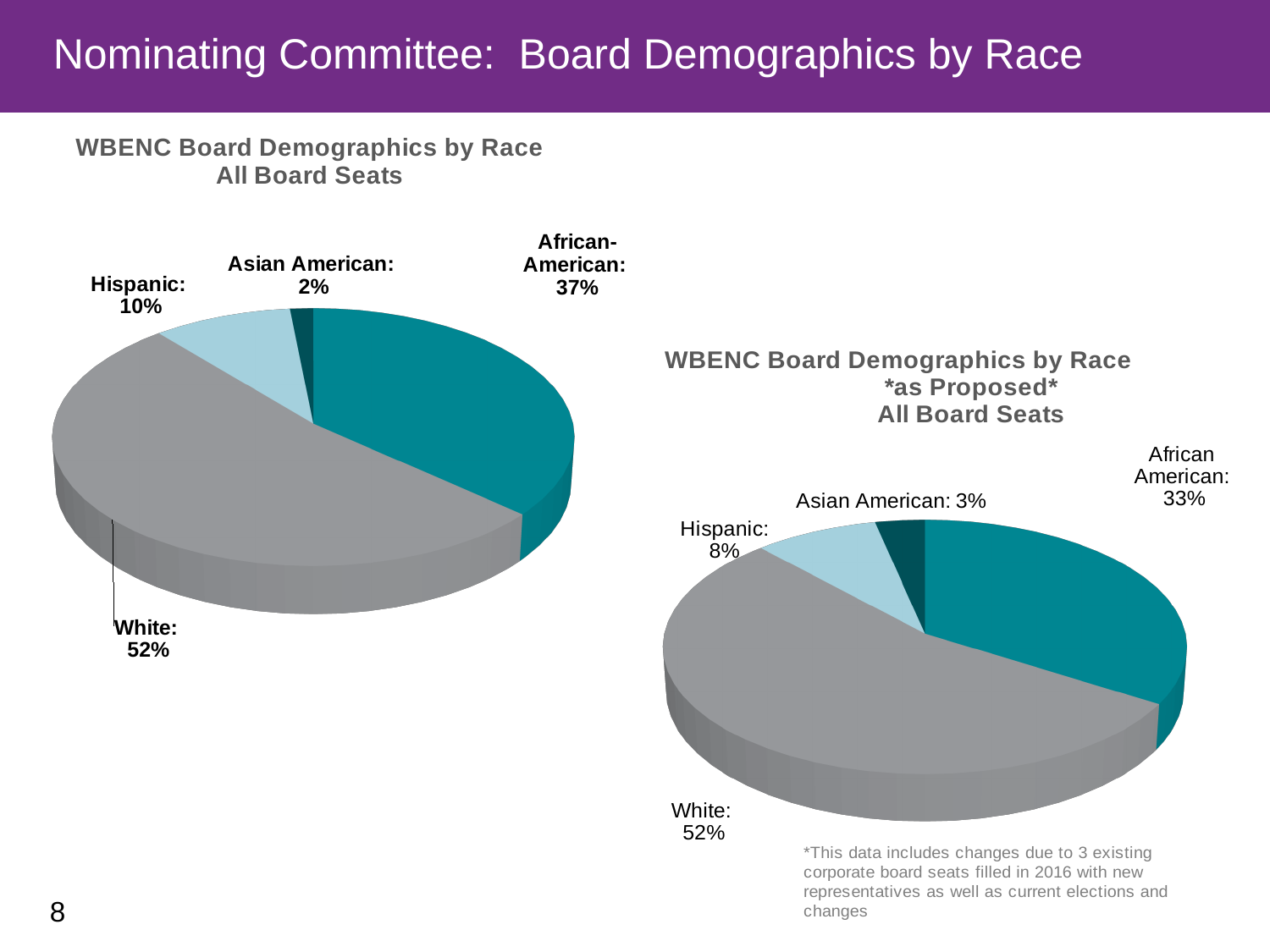
In the left pie chart (All Board Seats), what is the difference between the White share and the African-American share? 15% In the right pie chart (*as Proposed*), what is the difference between the Hispanic share and the Asian American share? 5% In the left pie chart (All Board Seats), which group holds the smallest share of board seats? Asian American In the right pie chart (*as Proposed*), what share of board seats is held by African American members? 33% How many categories are shown in the right pie chart (*as Proposed*)? 4 In the left pie chart (All Board Seats), what share of board seats is held by Hispanic members? 10% In the left pie chart (All Board Seats), which group holds the largest share of board seats? White In the right pie chart (*as Proposed*), what share of board seats is held by Asian American members? 3% Is the African-American share larger in the left pie chart (All Board Seats) or in the right pie chart (*as Proposed*)? Left (All Board Seats) In the right pie chart (*as Proposed*), which group holds the smallest share of board seats? Asian American What type of chart is used on the left side of the slide? Pie chart In the left pie chart (All Board Seats), what share of board seats is held by African-American members? 37%